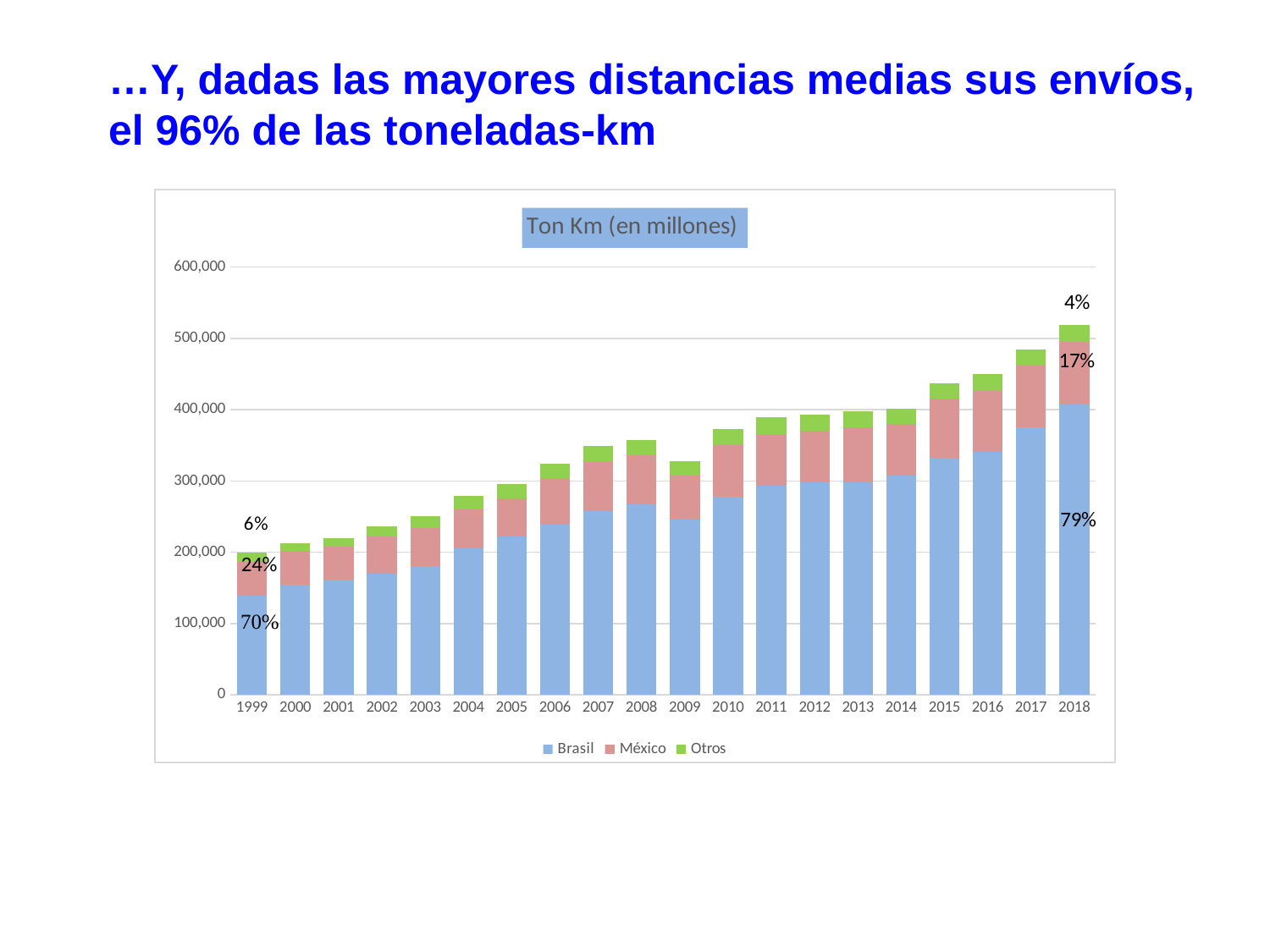
What kind of chart is shown on the slide? Stacked bar chart What percentage share is labelled for Brasil in 1999? 70% Is the total stacked value for 2009 greater or less than 400,000? less What percentage share is labelled for México in 1999? 24% How many years are shown along the x axis? 20 Is the total stacked value for 2015 greater or less than 400,000? greater How many series does the legend list? 3 What percentage share is labelled for Otros in 2018? 4% What is the title of the chart? Ton Km (en millones) By how many percentage points did Brasil's labelled share change between 1999 (70%) and 2018 (79%)? 9 percentage points What percentage share is labelled for Brasil in 2018? 79% Which year has the highest total Ton Km? 2018